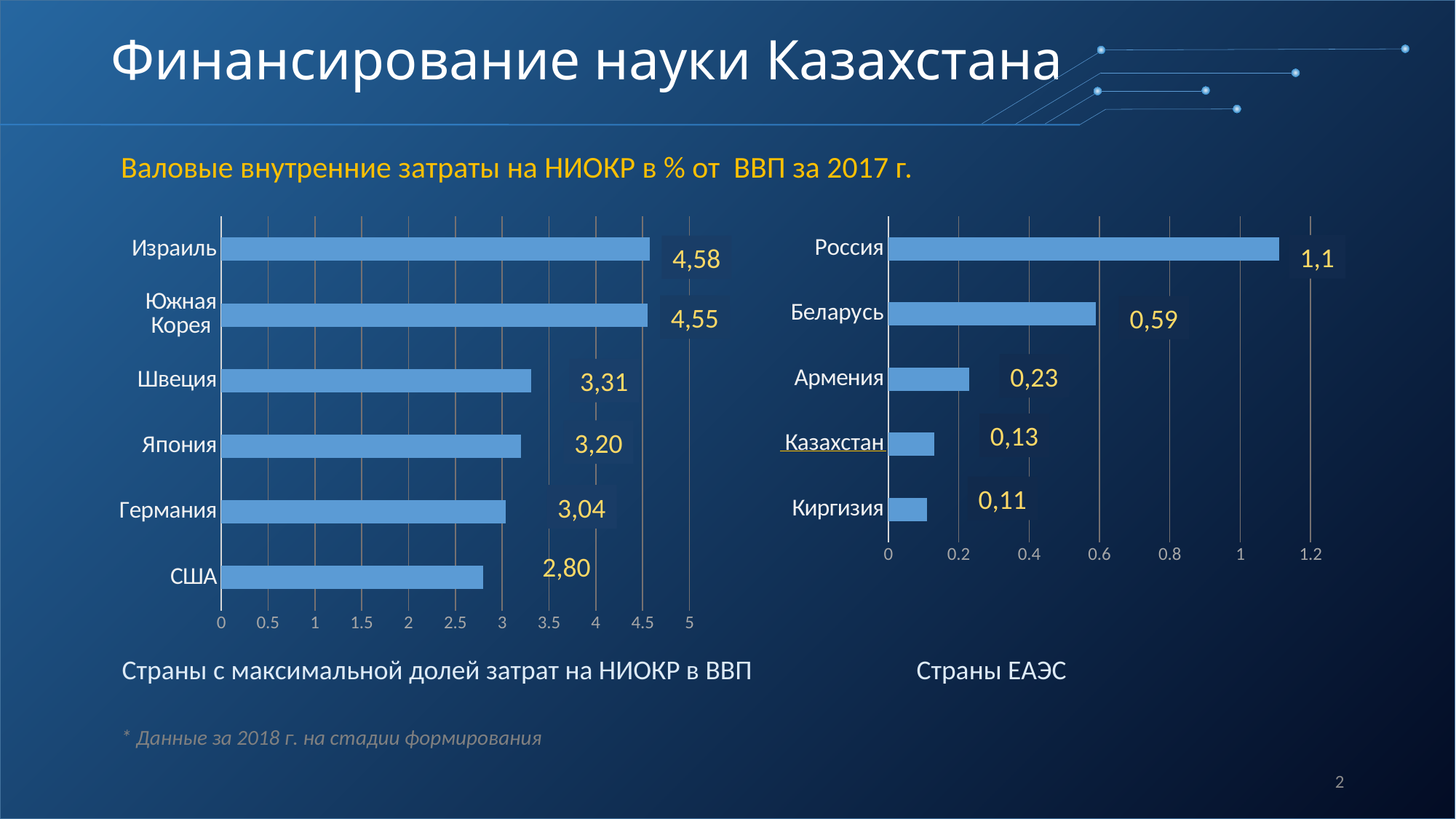
What type of chart is the left chart (Страны с максимальной долей затрат на НИОКР в ВВП)? Bar chart On the left chart (Страны с максимальной долей затрат на НИОКР в ВВП), what is the value for Германия? 3,04 On the left chart (Страны с максимальной долей затрат на НИОКР в ВВП), which country has the lowest value? США On the left chart (Страны с максимальной долей затрат на НИОКР в ВВП), what is the difference between Швеция and Япония? 0,11 On the right chart (Страны ЕАЭС), how many countries are shown? 5 On the right chart (Страны ЕАЭС), which is larger, the value for Армения or the value for Казахстан? Армения On the right chart (Страны ЕАЭС), what is the difference between Беларусь and Армения? 0,36 On the right chart (Страны ЕАЭС), what is the value for Казахстан? 0,13 On the left chart (Страны с максимальной долей затрат на НИОКР в ВВП), what is the value for Израиль? 4,58 On the left chart (Страны с максимальной долей затрат на НИОКР в ВВП), how many countries are shown? 6 On the right chart (Страны ЕАЭС), which country has the lowest value? Киргизия On the right chart (Страны ЕАЭС), which country has the highest value? Россия